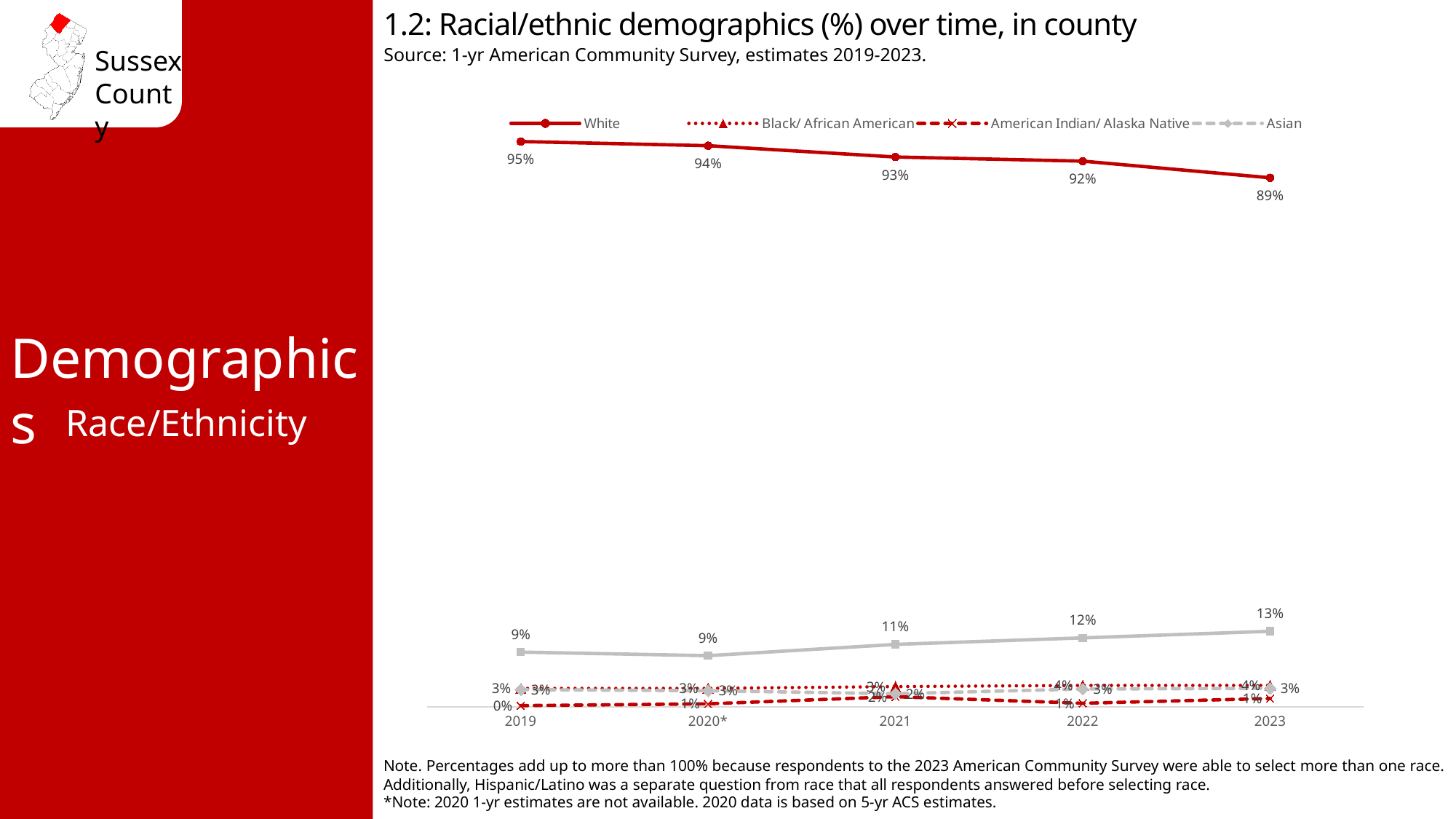
What is the value for White in 2021? 93% Which is larger, the White percentage in 2020* or in 2022? 2020* What is the value for American Indian/ Alaska Native in 2021? 2% How many years are shown on the x axis? 5 Does the White percentage rise or fall from 2019 to 2023? fall In which year is the White percentage lowest? 2023 What is the value for White in 2023? 89% In which year is the White percentage highest? 2019 What is the value for American Indian/ Alaska Native in 2019? 0% What kind of chart is this? line chart What is the difference between the White percentage in 2019 and in 2023? 6% What is the value for White in 2019? 95%